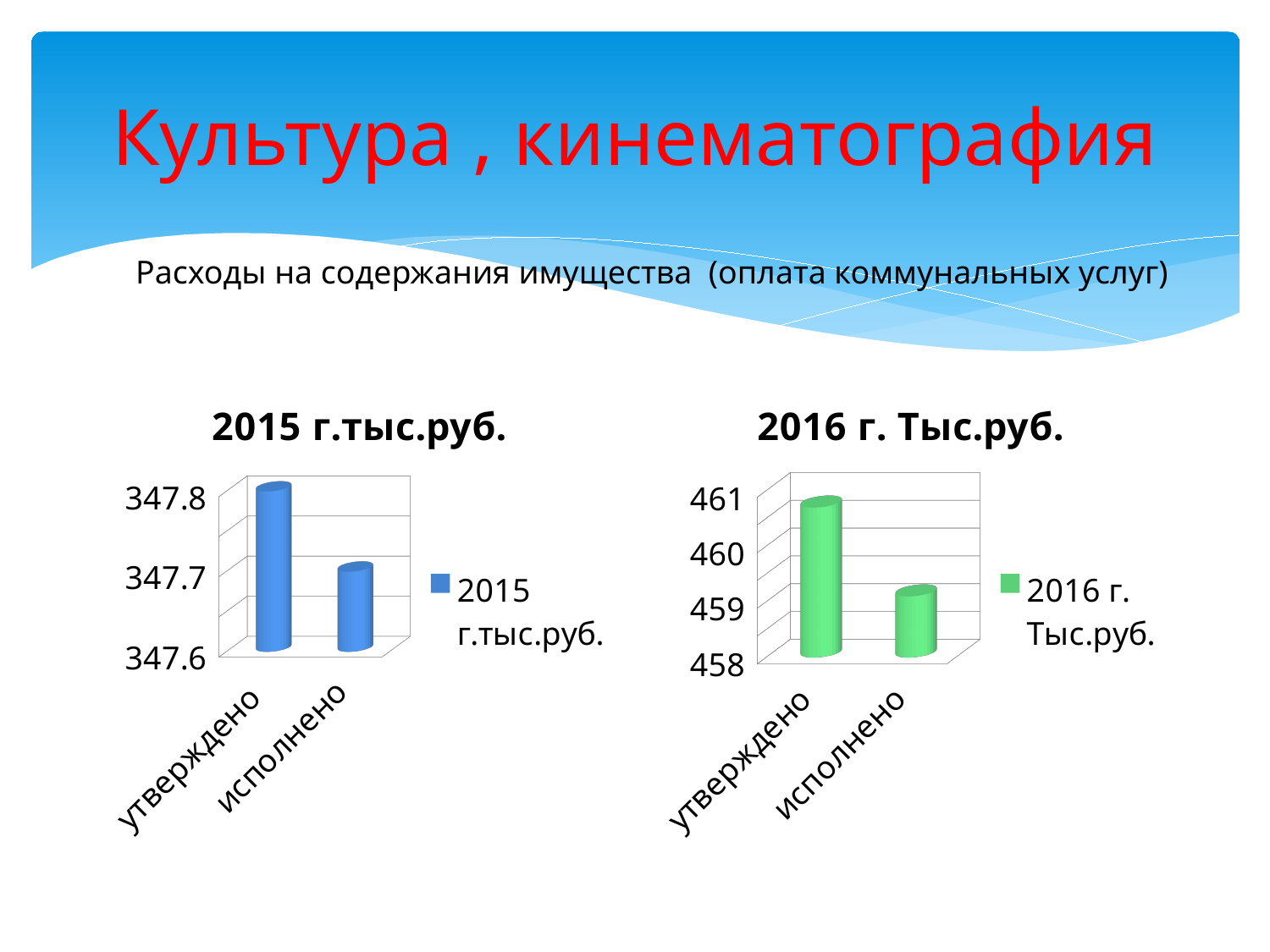
In the "2016 г. Тыс.руб." chart, which category has the lowest value? исполнено In the "2015 г.тыс.руб." chart, which category has the highest value? утверждено How many series does the legend of the "2015 г.тыс.руб." chart list? 1 What is the legend entry of the chart on the right? 2016 г. Тыс.руб. How many categories are shown in the "2016 г. Тыс.руб." chart? 2 In the "2016 г. Тыс.руб." chart, is the value for исполнено greater or less than 460? less What kind of chart is the "2015 г.тыс.руб." chart? bar chart In the "2016 г. Тыс.руб." chart, which is larger: утверждено or исполнено? утверждено In the "2015 г.тыс.руб." chart, is the value for утверждено greater or less than 347.7? greater In the "2015 г.тыс.руб." chart, is the value for исполнено greater or less than 347.8? less What colour are the bars in the "2015 г.тыс.руб." chart? blue